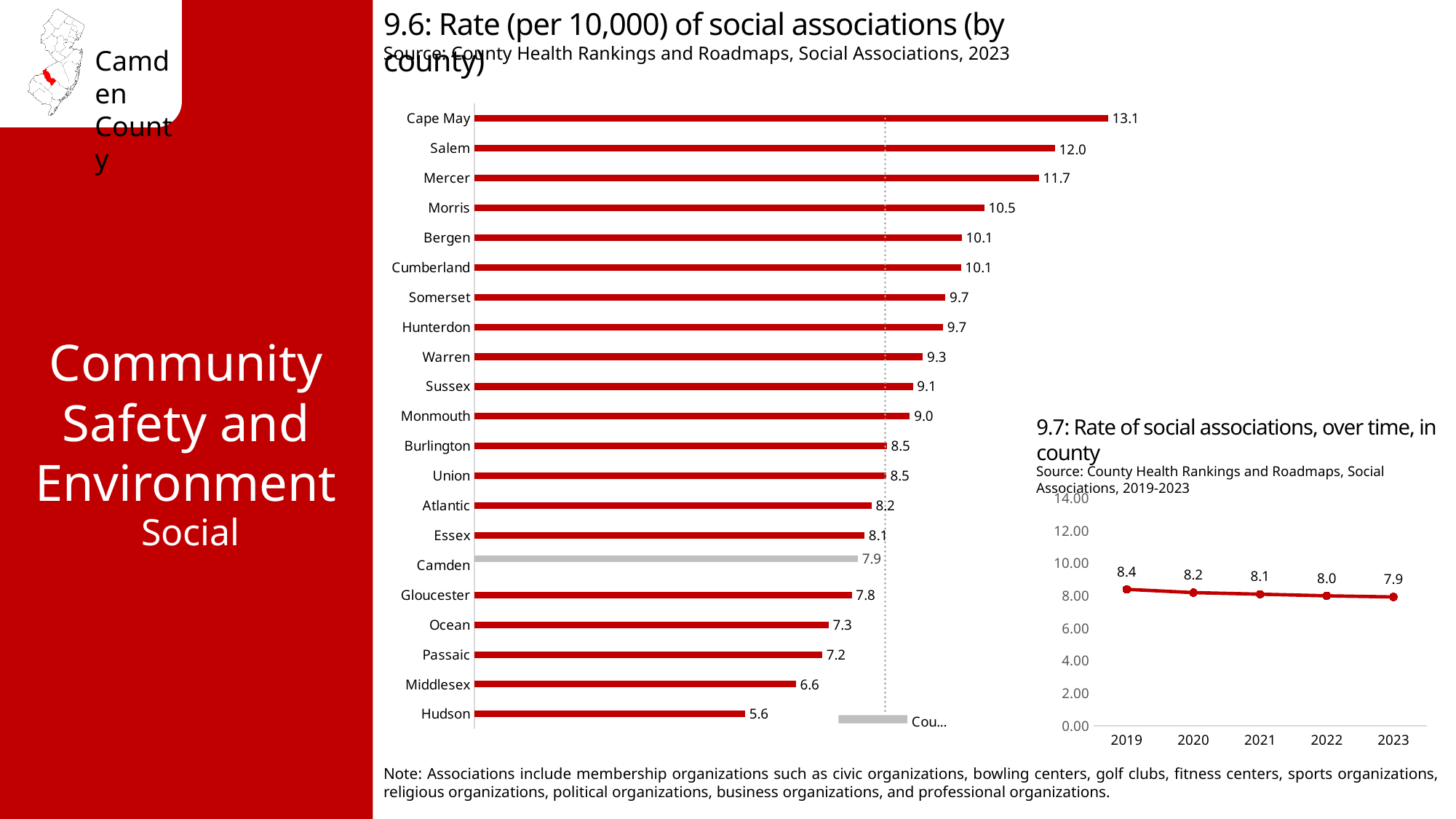
In chart 9.6, which county has the highest rate of social associations? Cape May In chart 9.7, does the rate of social associations rise or fall from 2019 to 2023? Fall In chart 9.7, what was the rate of social associations in 2019? 8.4 In chart 9.6, which county has a higher rate, Mercer or Morris? Mercer What type of chart is chart 9.6? Bar chart In chart 9.7, what was the rate of social associations in 2023? 7.9 In chart 9.6, what is the difference between the rates for Cape May and Hudson? 7.5 In chart 9.6, what is the rate of social associations for Camden? 7.9 In chart 9.6, which county has the lowest rate of social associations? Hudson In chart 9.6, what is the rate of social associations for Cape May? 13.1 In chart 9.6, how many counties are shown? 21 In chart 9.7, how many years are plotted? 5